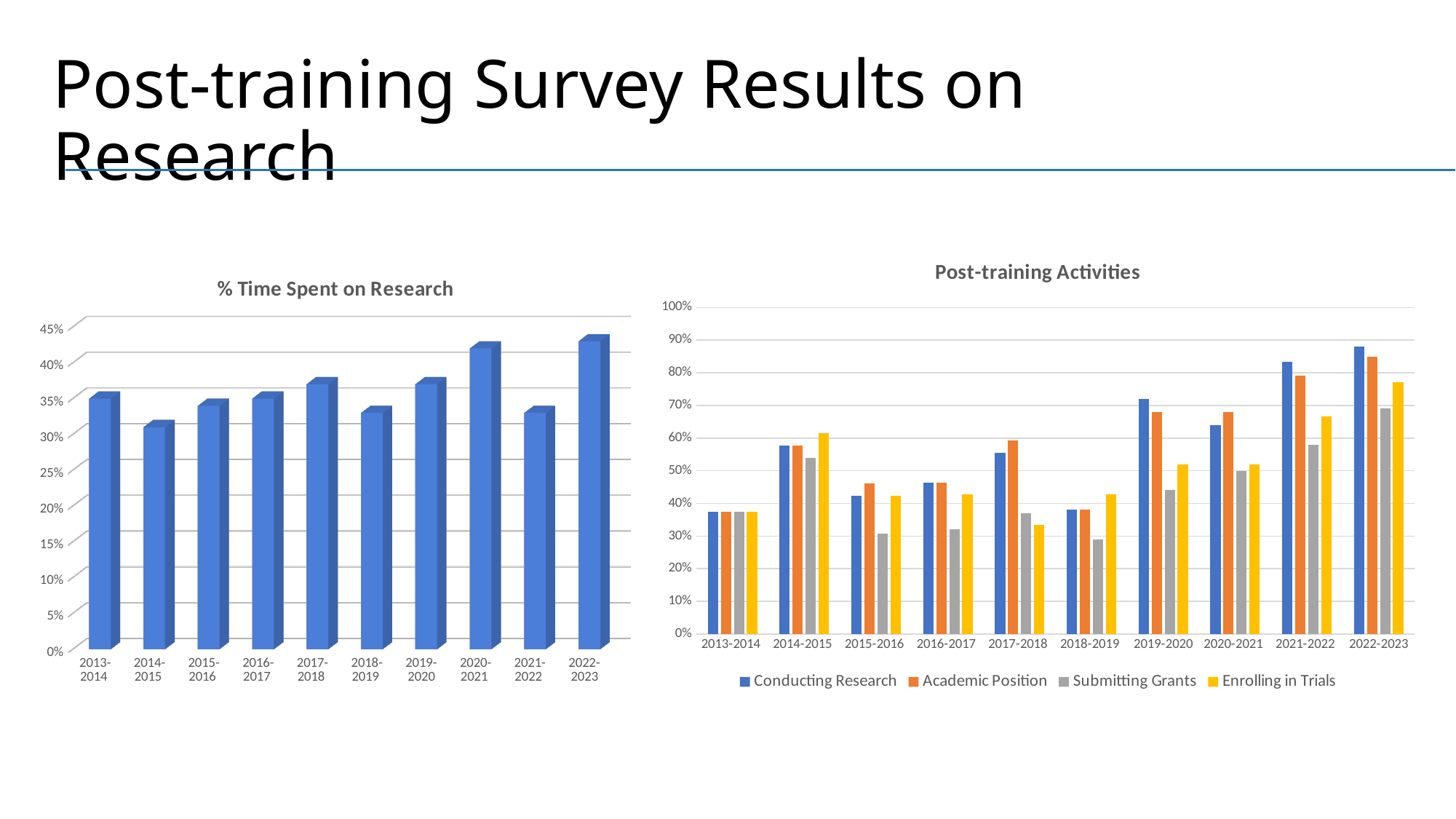
On the 'Post-training Activities' chart, which year has the highest value for Conducting Research? 2022-2023 On the '% Time Spent on Research' chart, which is larger, the value for 2017-2018 or 2018-2019? 2017-2018 On the 'Post-training Activities' chart, is the Conducting Research value for 2022-2023 greater or less than 80%? greater On the 'Post-training Activities' chart, which is larger in 2017-2018, Academic Position or Enrolling in Trials? Academic Position On the '% Time Spent on Research' chart, which year has the highest value? 2022-2023 How many academic years are shown on the '% Time Spent on Research' chart? 10 On the '% Time Spent on Research' chart, is the value for 2020-2021 greater or less than 40%? greater On the 'Post-training Activities' chart, is the Submitting Grants value for 2015-2016 greater or less than 40%? less On the 'Post-training Activities' chart, what colour are the Enrolling in Trials bars? yellow What kind of chart is the '% Time Spent on Research' chart? bar chart How many series does the legend of the 'Post-training Activities' chart list? 4